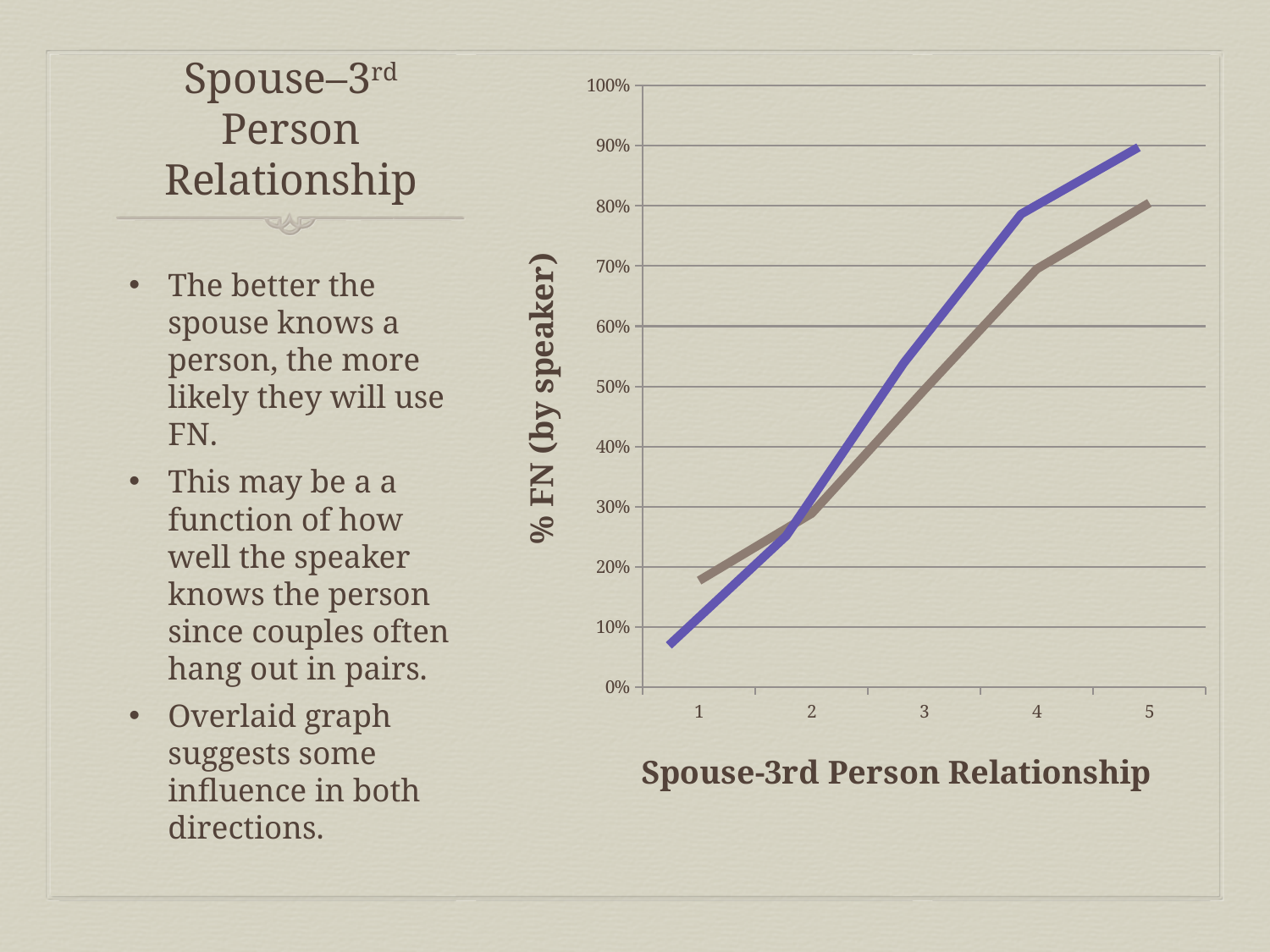
Is the value of the brown line at x = 5 greater or less than 70%? greater Do the values of the blue line rise or fall as the x axis goes from 1 to 5? rise At which x-axis value does the blue line reach its highest point? 5 What kind of chart is shown on the slide? line chart At x = 1, which line has the higher value, the blue line or the brown line? the brown line How many points along the x axis does each line in the chart have? 5 What is the title of the chart's x axis? Spouse-3rd Person Relationship How many lines are plotted in the chart? 2 Is the value of the blue line at x = 5 greater or less than 80%? greater At x = 5, which line has the higher value, the blue line or the brown line? the blue line Is the value of the brown line at x = 4 greater or less than 80%? less